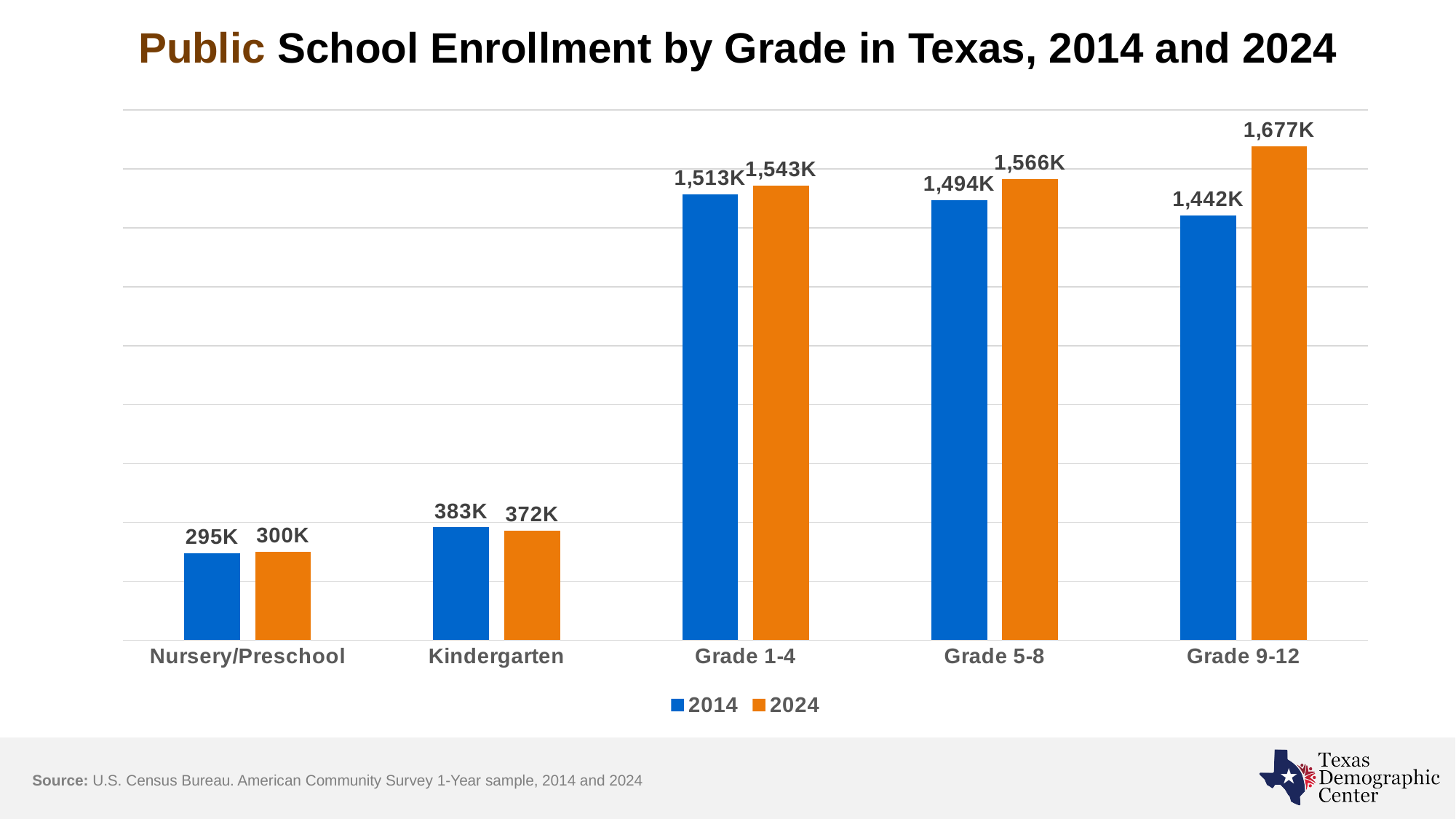
What was public school enrollment for Kindergarten in Texas in 2014? 383K Which was larger for Grade 5-8: enrollment in 2014 or in 2024? 2024 What kind of chart is shown on the slide? Bar chart Which was larger for Kindergarten: enrollment in 2014 or in 2024? 2014 What was public school enrollment for Grade 9-12 in Texas in 2024? 1,677K How many grade groups are shown on the x axis? 5 What was public school enrollment for Nursery/Preschool in Texas in 2024? 300K What is the difference between 2014 and 2024 enrollment for Kindergarten? 11K Which grade group had the lowest enrollment in 2014? Nursery/Preschool How many series does the legend list? 2 What is the difference between 2024 and 2014 enrollment for Grade 9-12? 235K Which grade group had the highest enrollment in 2024? Grade 9-12